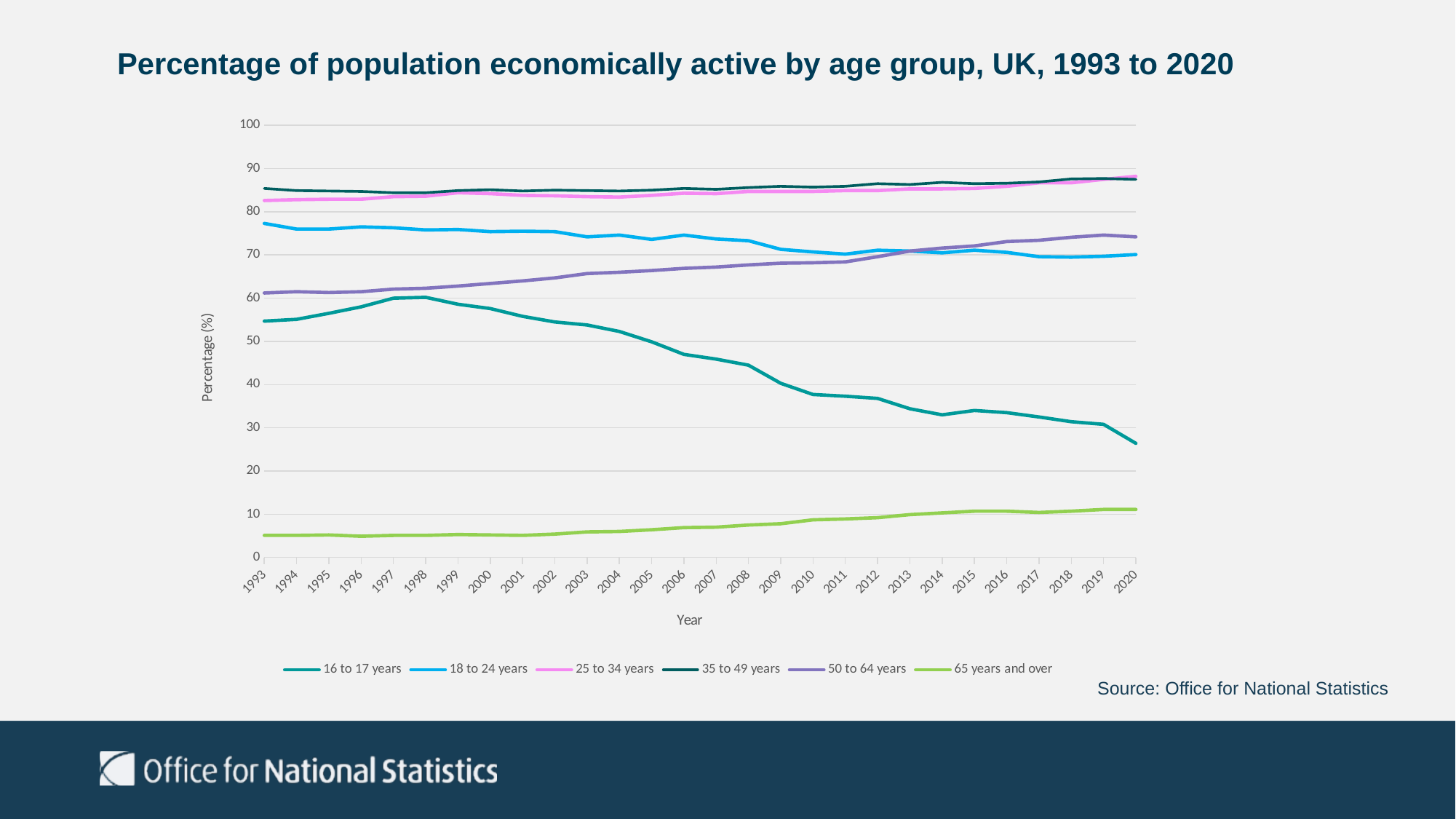
Is the value for 16 to 17 years in 2020 greater or less than 30? less How many series does the legend list? 6 What kind of chart is shown on the slide? line chart In 2020, which is larger: the value for 16 to 17 years or the value for 18 to 24 years? 18 to 24 years Is the value for 50 to 64 years in 2020 greater or less than 70? greater Which age group has the lowest value in 2020? 65 years and over What is the title of the y axis? Percentage (%) Does the value for 16 to 17 years rise or fall overall from 1993 to 2020? fall Does the value for 50 to 64 years rise or fall overall from 1993 to 2020? rise How many years are shown on the x axis? 28 Does the value for 65 years and over rise or fall overall from 1993 to 2020? rise Is the value for 65 years and over in 1993 greater or less than 10? less